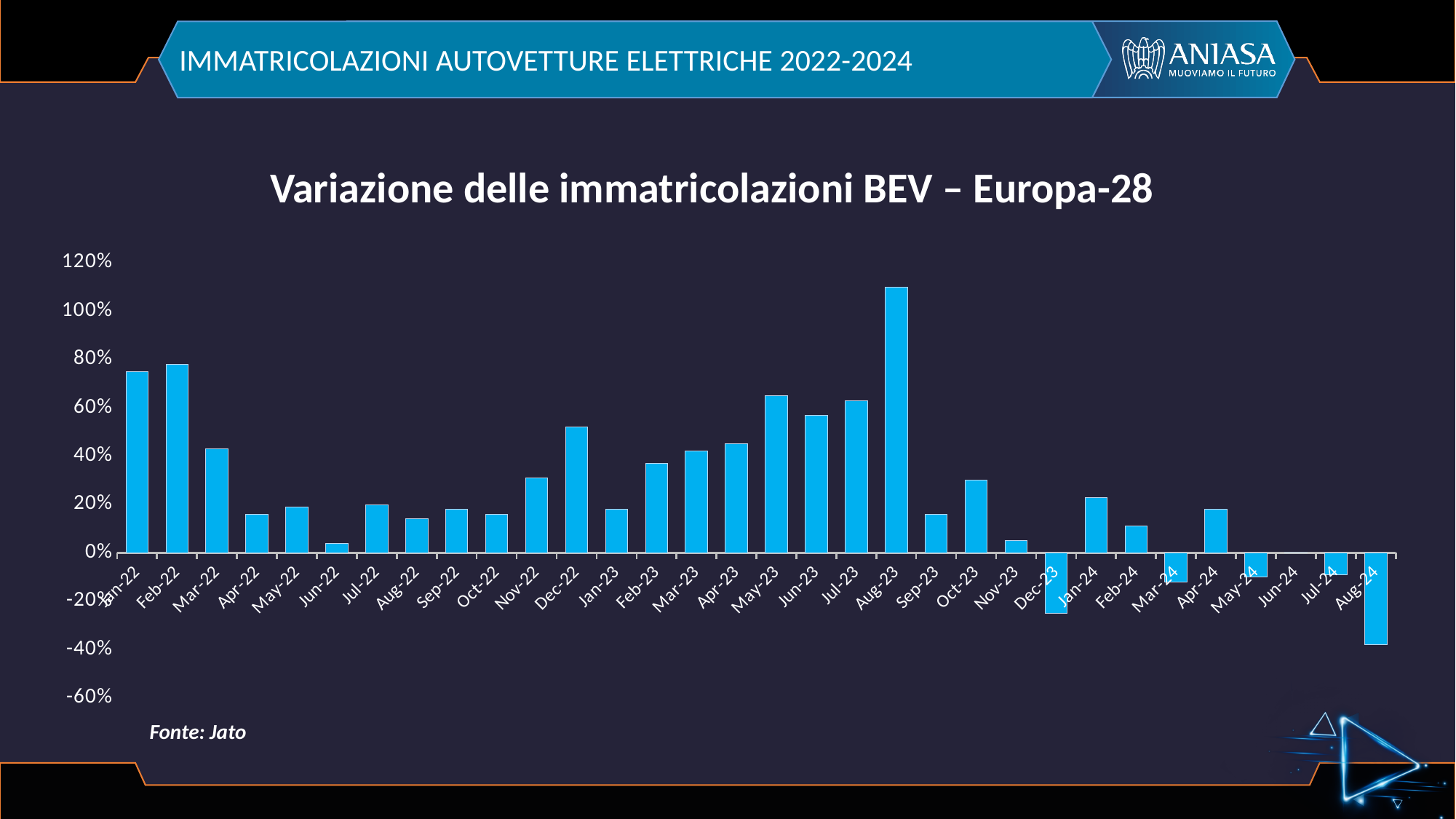
Which is larger, the value for Dec-22 or the value for Nov-22? Dec-22 What kind of chart is shown on the slide? bar chart Which month has the lowest value? Aug-24 How many months are plotted on the x axis? 32 Is the value for Aug-23 greater or less than 100%? greater What is the title of the chart? Variazione delle immatricolazioni BEV – Europa-28 Is the value for Jun-22 greater or less than 20%? less What source is cited below the chart? Jato Do the values generally rise or fall from Aug-23 to Aug-24? fall Is the value for Aug-24 greater or less than -20%? less Which month has the highest value? Aug-23